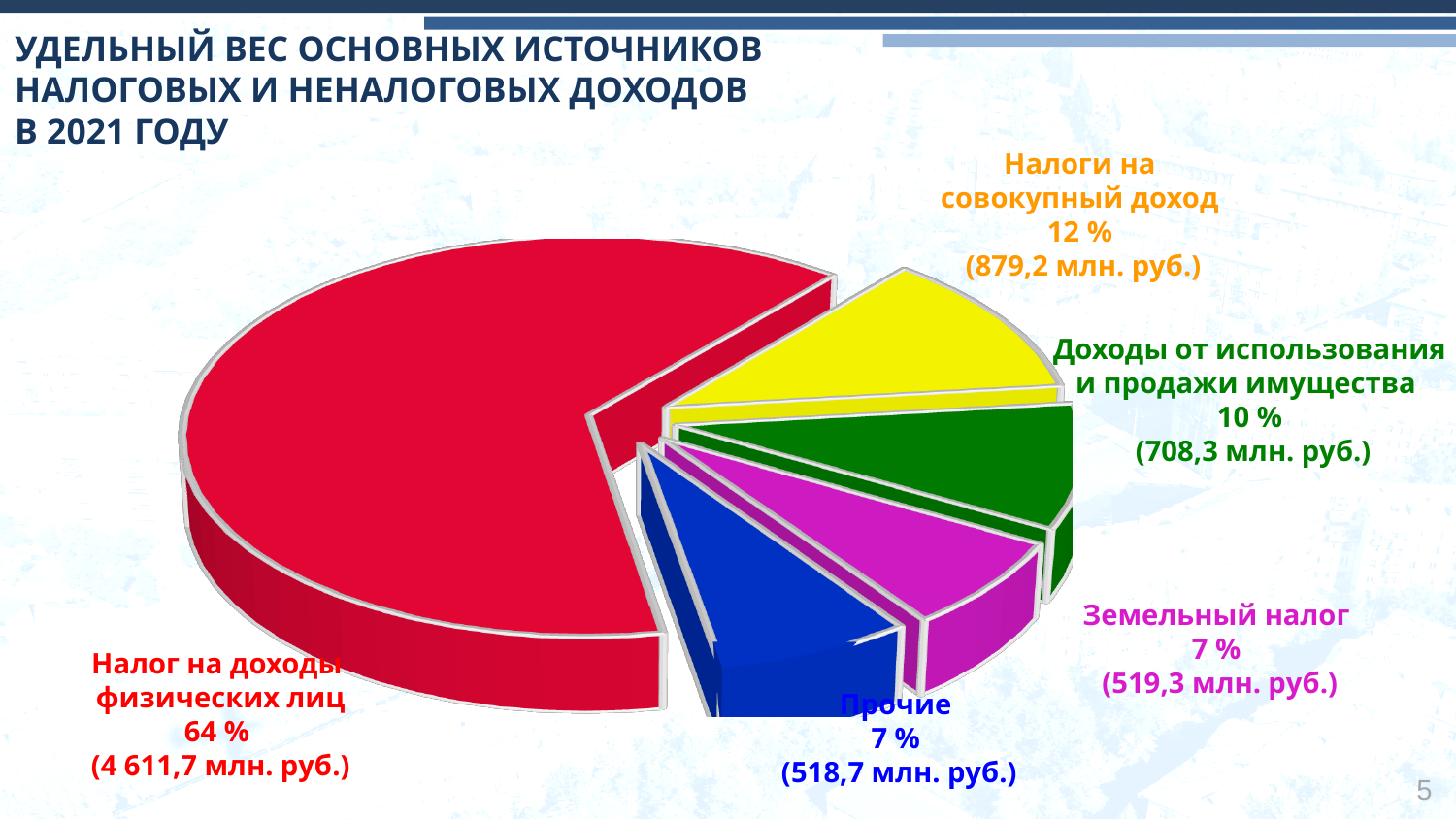
What type of chart is shown on the slide? Pie chart What share of the pie does "Земельный налог" represent? 7 % Which is larger: "Налоги на совокупный доход" or "Доходы от использования и продажи имущества"? Налоги на совокупный доход What is the difference in млн. руб. between "Налоги на совокупный доход" and "Доходы от использования и продажи имущества"? 170,9 млн. руб. What is the difference in млн. руб. between "Земельный налог" and "Прочие"? 0,6 млн. руб. What colour is the slice for "Налог на доходы физических лиц"? Red Which category has the largest slice of the pie? Налог на доходы физических лиц What is the value in млн. руб. for "Налоги на совокупный доход"? 879,2 млн. руб. How many slices does the pie chart have? 5 What share of the pie does "Налог на доходы физических лиц" represent? 64 % What is the value in млн. руб. for "Прочие"? 518,7 млн. руб. What is the value in млн. руб. for "Доходы от использования и продажи имущества"? 708,3 млн. руб.